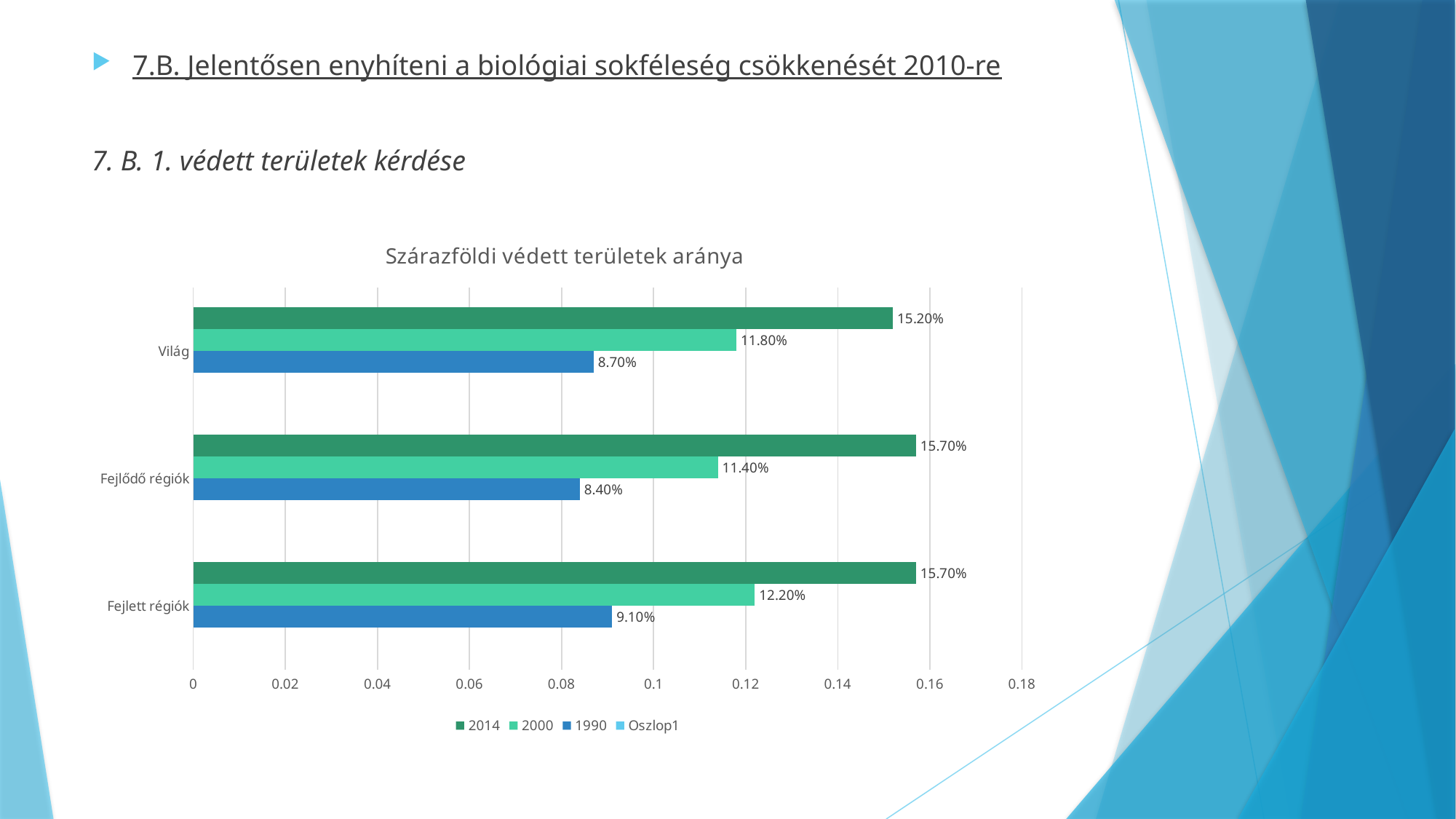
What is the difference between the 2000 and 1990 values for Fejlett régiók? 3.10% What is the value for Világ in the 2014 series? 15.20% Which category has the highest value in the 1990 series? Fejlett régiók Which is larger: the 2000 value for Világ or the 2000 value for Fejlődő régiók? Világ Which category has the lowest value in the 2000 series? Fejlődő régiók Which category has the lowest value in the 2014 series? Világ What is the value for Fejlett régiók in the 2000 series? 12.20% What is the difference between the 2014 and 1990 values for Világ? 6.50% What is the value for Fejlődő régiók in the 1990 series? 8.40% How many series does the legend list? 4 What is the title of the chart? Szárazföldi védett területek aránya How many categories are shown on the chart? 3